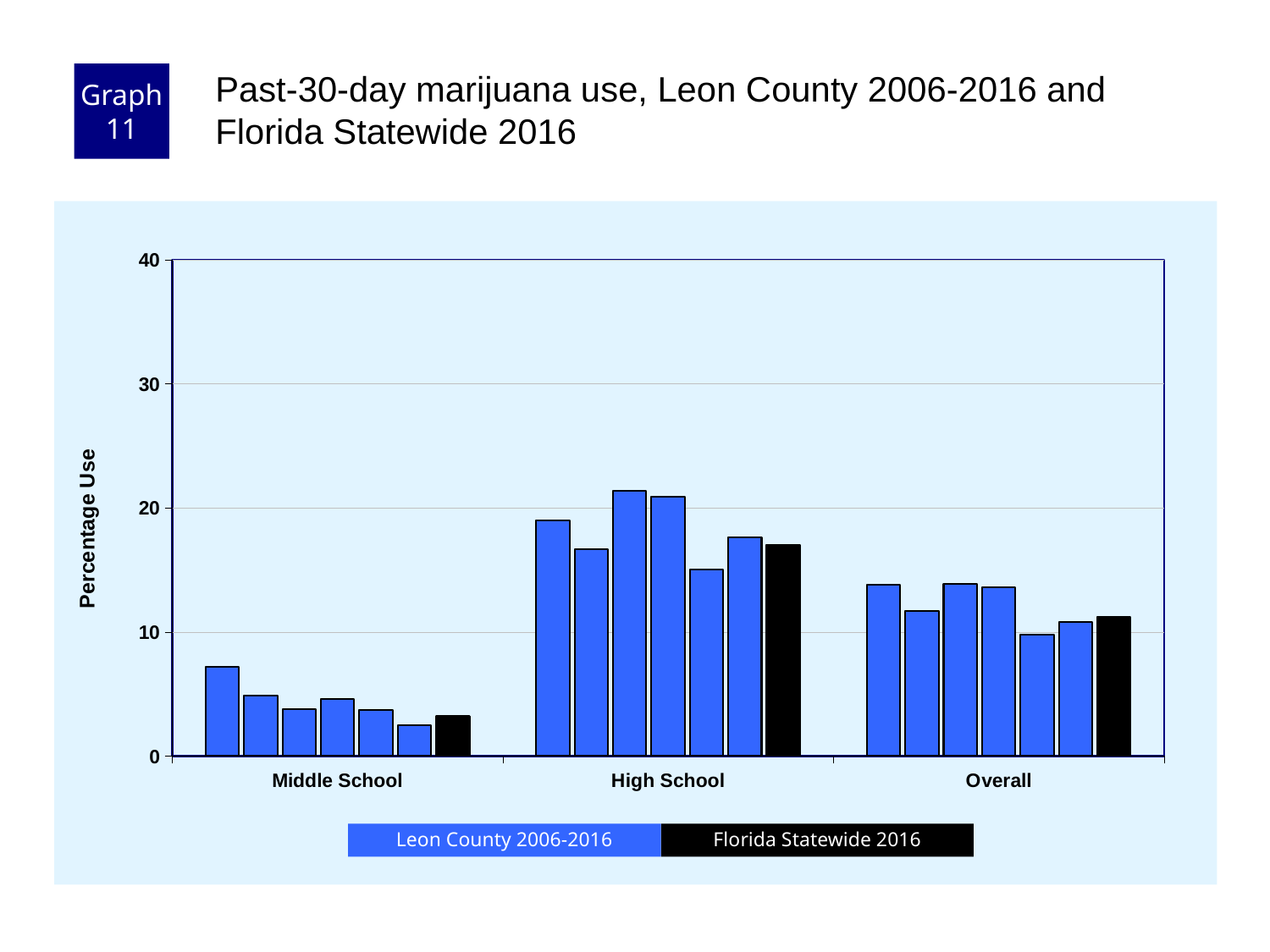
Do the Leon County 2006-2016 bars for Middle School generally rise or fall from left to right? fall How many series does the legend list? 2 Which is larger, the Florida Statewide 2016 value for High School or for Middle School? High School What is the label on the y axis? Percentage Use How many categories are shown on the x axis? 3 Is the Florida Statewide 2016 value for Overall greater or less than 20? less Is the Florida Statewide 2016 value for High School greater or less than 10? greater Which category has the lowest bars overall? Middle School Is the Florida Statewide 2016 value for High School greater or less than 20? less Which category has the highest bars overall? High School What kind of chart is shown on the slide? bar chart